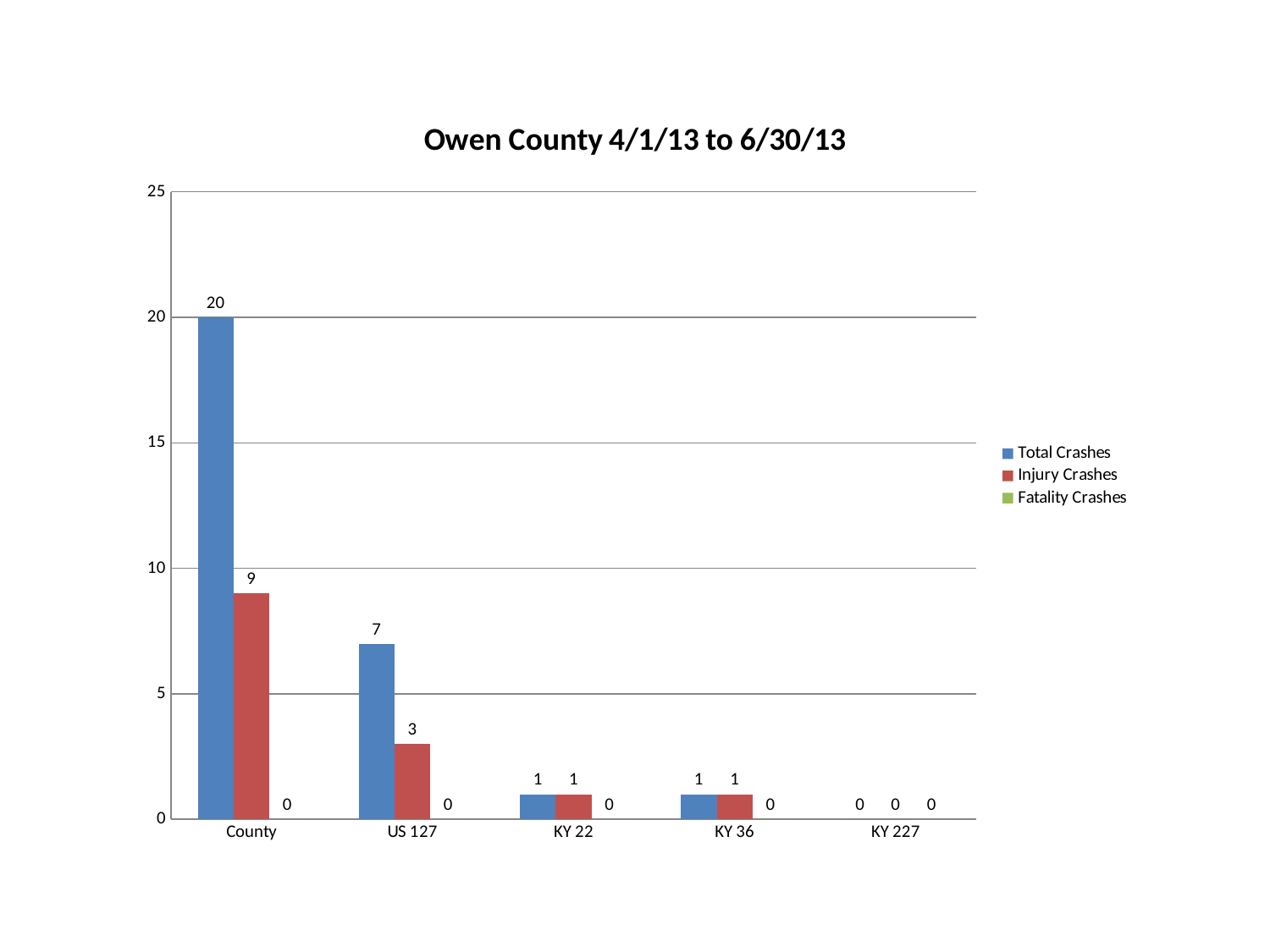
What is the difference between Total Crashes and Injury Crashes for County? 11 Which category has the highest Total Crashes value? County How many categories are shown on the x axis? 5 Which category has the lowest Total Crashes value? KY 227 How many series does the legend list? 3 What kind of chart is shown on the slide? bar chart Is the value of Total Crashes for County greater or less than 15? greater Which is larger, Total Crashes for US 127 or Injury Crashes for County? Injury Crashes for County What is the value of Total Crashes for County? 20 What is the title of the chart? Owen County 4/1/13 to 6/30/13 What is the value of Injury Crashes for US 127? 3 What is the value of Fatality Crashes for KY 36? 0